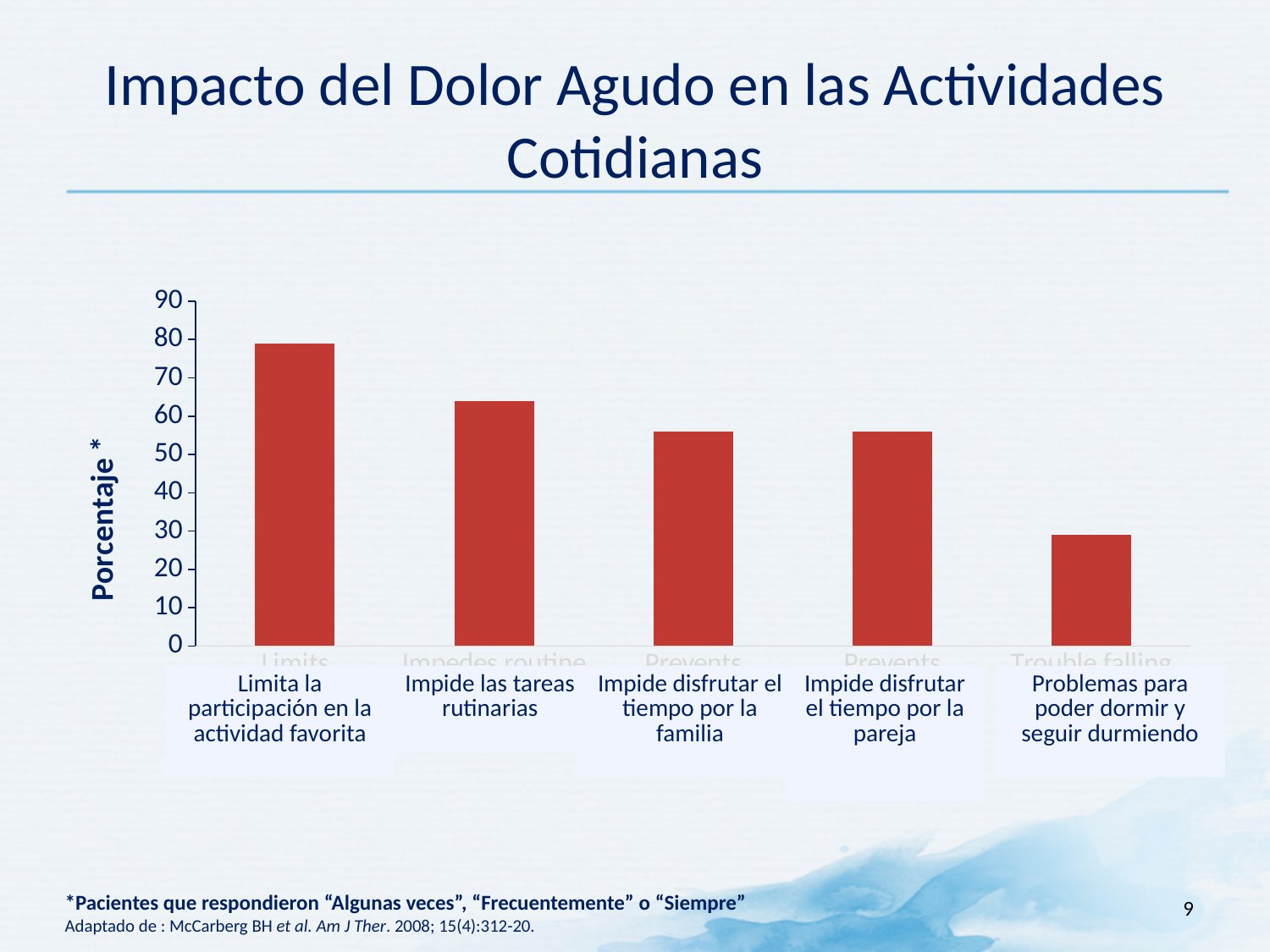
What kind of chart is shown on the slide? bar chart Is the value for "Limita la participación en la actividad favorita" greater or less than 70? greater Which category has the highest value? Limita la participación en la actividad favorita How many categories (bars) does the chart show? 5 Do the bar values rise or fall from left to right across the chart? fall Which category has the lowest value? Problemas para poder dormir y seguir durmiendo Is the value for "Impide las tareas rutinarias" greater or less than 60? greater What is the title of the slide containing the chart? Impacto del Dolor Agudo en las Actividades Cotidianas Which is larger: the value for "Limita la participación en la actividad favorita" or for "Impide las tareas rutinarias"? Limita la participación en la actividad favorita Is the value for "Impide disfrutar el tiempo por la familia" greater or less than 60? less What is the label of the vertical axis? Porcentaje *